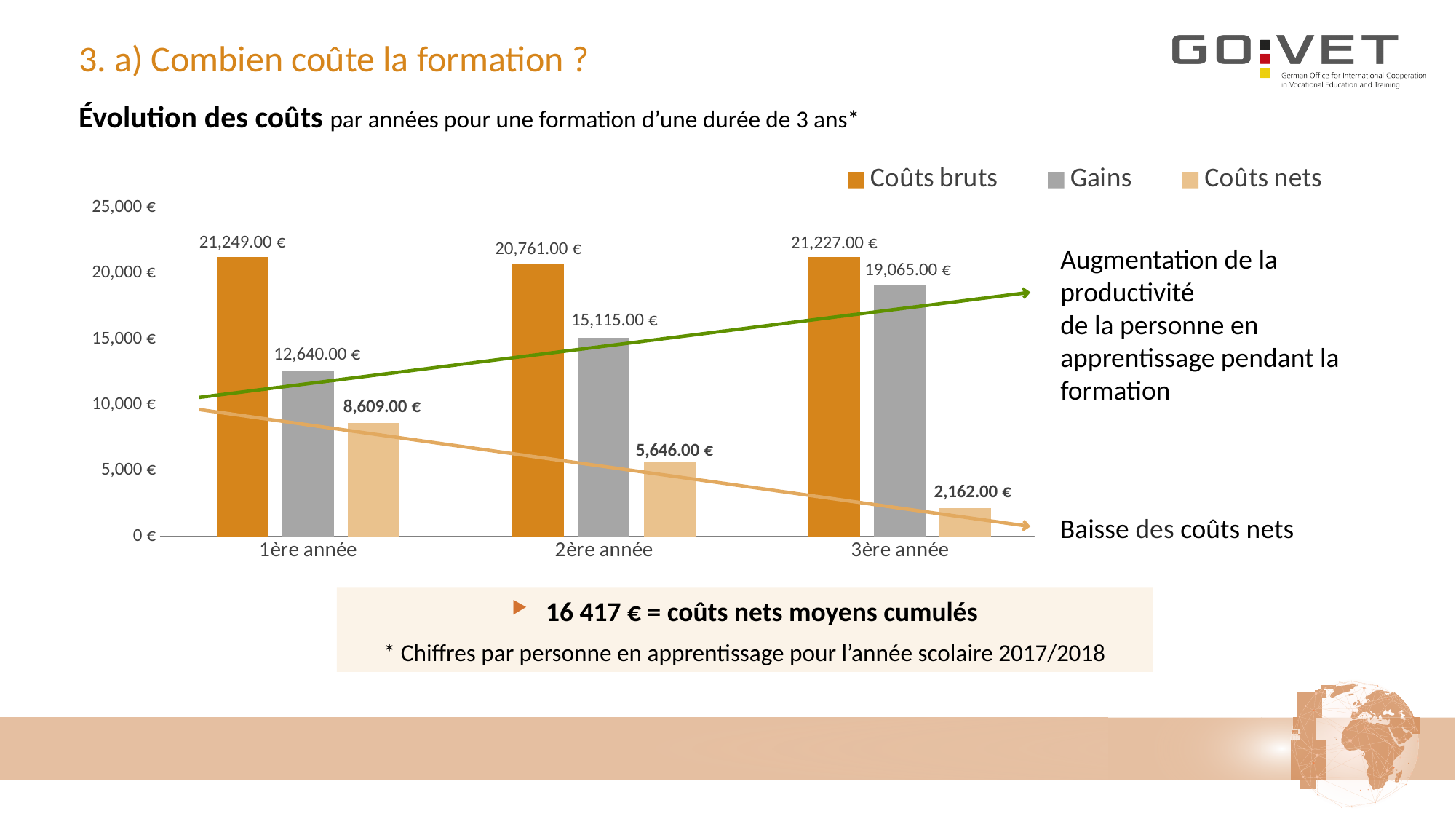
Is the value of Gains for 1ère année greater or less than 15,000 €? less In which year is Coûts nets the lowest? 3ère année How many year categories are shown on the x axis? 3 What is the difference between Coûts bruts and Gains for 2ère année? 5,646.00 € What is the value of Coûts nets for 2ère année? 5,646.00 € Do the Coûts nets values rise or fall from 1ère année to 3ère année? fall What is the value of Coûts bruts for 1ère année? 21,249.00 € In which year is Gains the highest? 3ère année What is the value of Gains for 3ère année? 19,065.00 € What kind of chart is shown on the slide? bar chart How many series does the legend list? 3 Which is larger for 1ère année: Gains or Coûts nets? Gains